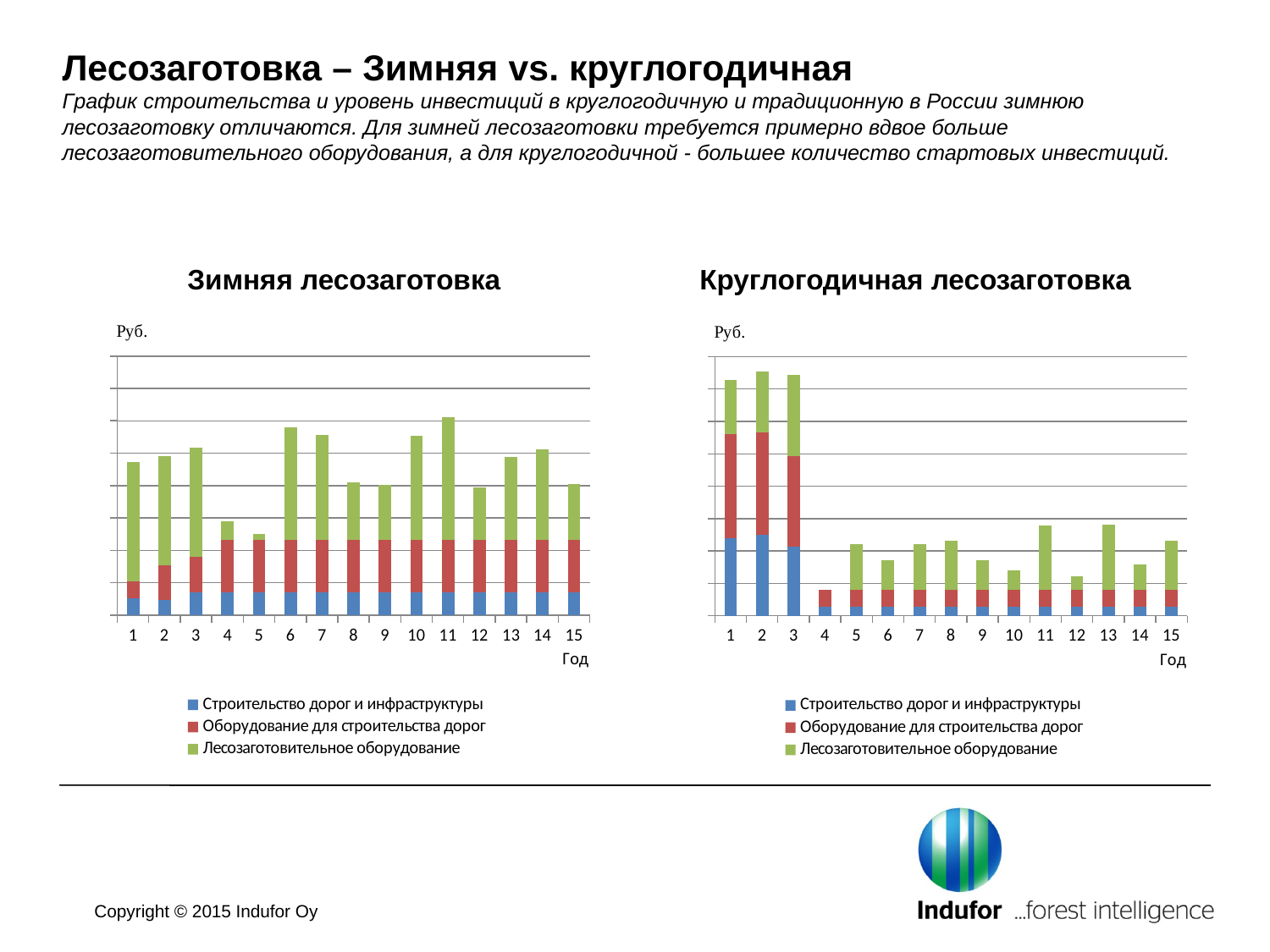
In the "Зимняя лесозаготовка" chart, which is larger: the total bar for year 6 or the total bar for year 12? Year 6 What kind of chart is the "Зимняя лесозаготовка" chart? Stacked bar chart How many series does the legend of the "Зимняя лесозаготовка" chart list? 3 Which legend entry is shown in green in the "Круглогодичная лесозаготовка" chart? Лесозаготовительное оборудование In the "Круглогодичная лесозаготовка" chart, do the total bars rise or fall from year 3 to year 4? Fall In the "Круглогодичная лесозаготовка" chart, which year has the lowest total bar? 4 In the "Зимняя лесозаготовка" chart, which year has the highest total bar? 11 In the "Круглогодичная лесозаготовка" chart, is the total bar for year 1 larger or smaller than the total bar for year 10? Larger What unit label is shown on the vertical axis of the "Зимняя лесозаготовка" chart? Руб. How many years (categories) are shown on the x axis of the "Круглогодичная лесозаготовка" chart? 15 In the "Зимняя лесозаготовка" chart, which year has the lowest total bar? 5